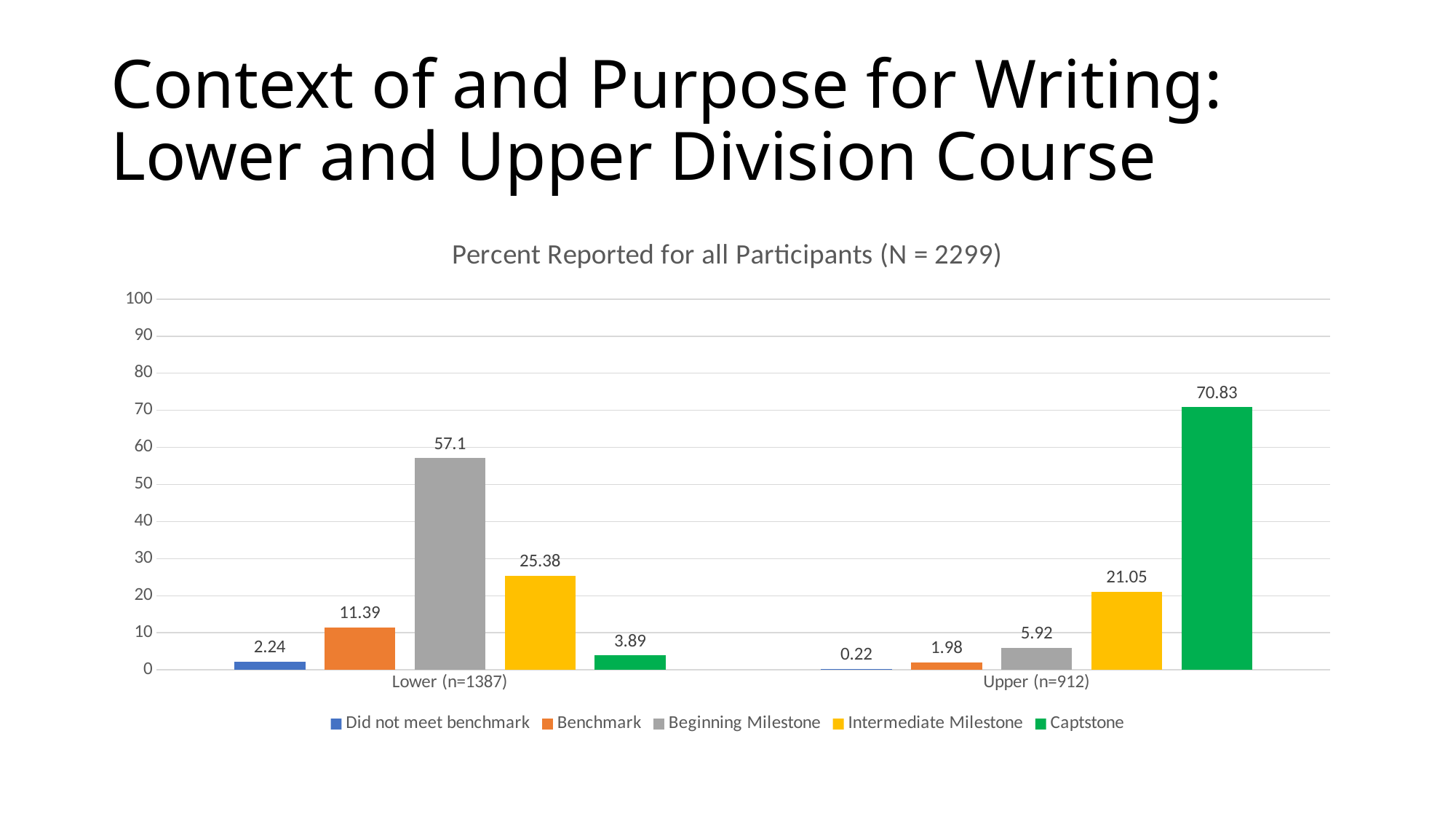
What is the difference between the Captstone values for Upper (n=912) and Lower (n=1387)? 66.94 What is the value for Intermediate Milestone in the Lower (n=1387) group? 25.38 Which series has the highest value in the Upper (n=912) group? Captstone How many series does the legend list? 5 What is the value for Beginning Milestone in the Lower (n=1387) group? 57.1 Which is larger: Benchmark for Lower (n=1387) or Beginning Milestone for Upper (n=912)? Benchmark for Lower (n=1387) How many category groups are shown on the x axis? 2 What is the value for Did not meet benchmark in the Upper (n=912) group? 0.22 Which series has the lowest value in the Lower (n=1387) group? Did not meet benchmark What kind of chart is shown on the slide? Bar chart What is the value for Captstone in the Upper (n=912) group? 70.83 What is the title of the chart? Percent Reported for all Participants (N = 2299)